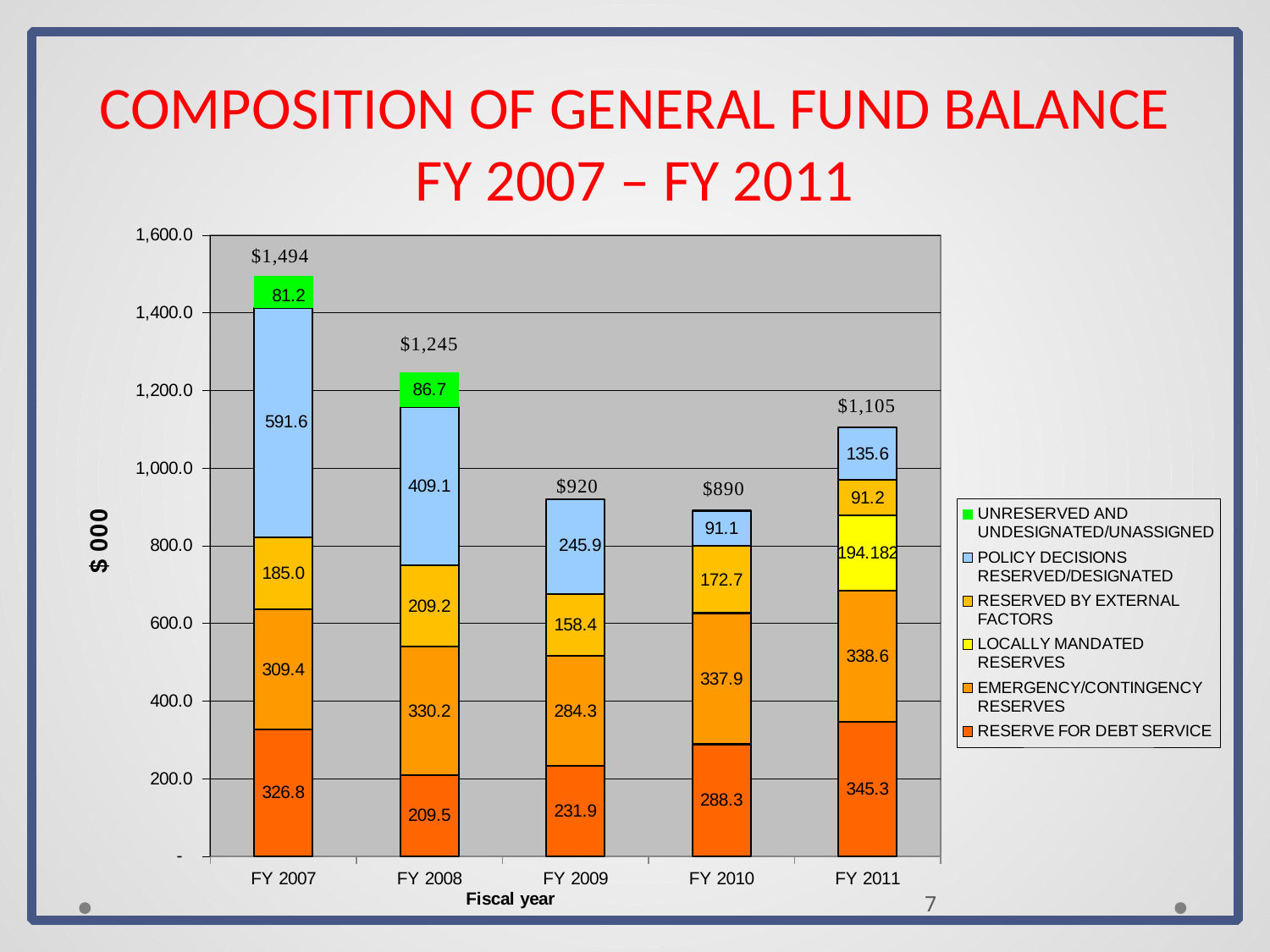
Which fiscal year has the lowest total general fund balance? FY 2010 What is the difference between POLICY DECISIONS RESERVED/DESIGNATED in FY 2007 and FY 2008? 182.5 How many fiscal years are shown on the x axis? 5 Which is larger, RESERVE FOR DEBT SERVICE in FY 2008 or in FY 2009? FY 2009 Which fiscal year has the highest total general fund balance? FY 2007 How many series does the legend list? 6 What is the total general fund balance shown for FY 2007? $1,494 What is the value of POLICY DECISIONS RESERVED/DESIGNATED for FY 2008? 409.1 What is the value of RESERVE FOR DEBT SERVICE for FY 2007? 326.8 From FY 2007 to FY 2010, do the total general fund balances rise or fall? fall What is the value of EMERGENCY/CONTINGENCY RESERVES for FY 2010? 337.9 What is the value of LOCALLY MANDATED RESERVES for FY 2011? 194.182